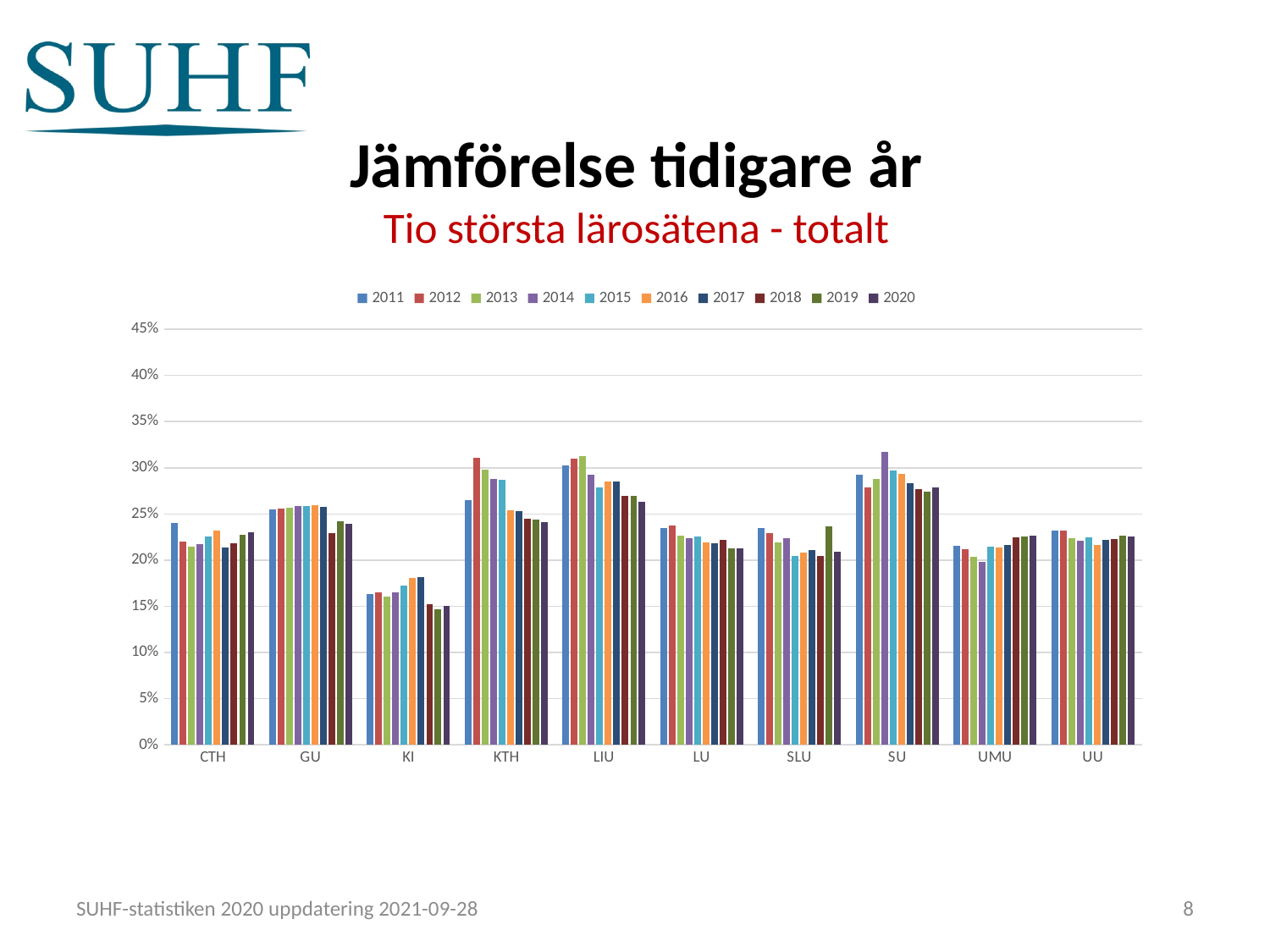
Is the value for SU in 2014 greater or less than 30%? greater What kind of chart is shown on the slide? bar chart Is the value for KTH in 2012 greater or less than 30%? greater Do the values for KTH rise or fall from 2012 to 2020? fall How many institutions (categories) are shown on the x axis? 10 Is the value for KI in 2011 greater or less than 20%? less What is the red subtitle of the chart on the slide? Tio största lärosätena - totalt Which institution has the lowest values overall? KI Which institution has the tallest single bar in the chart? SU Which is larger, the 2011 value for KI or the 2011 value for KTH? KTH How many series (years) does the legend list? 10